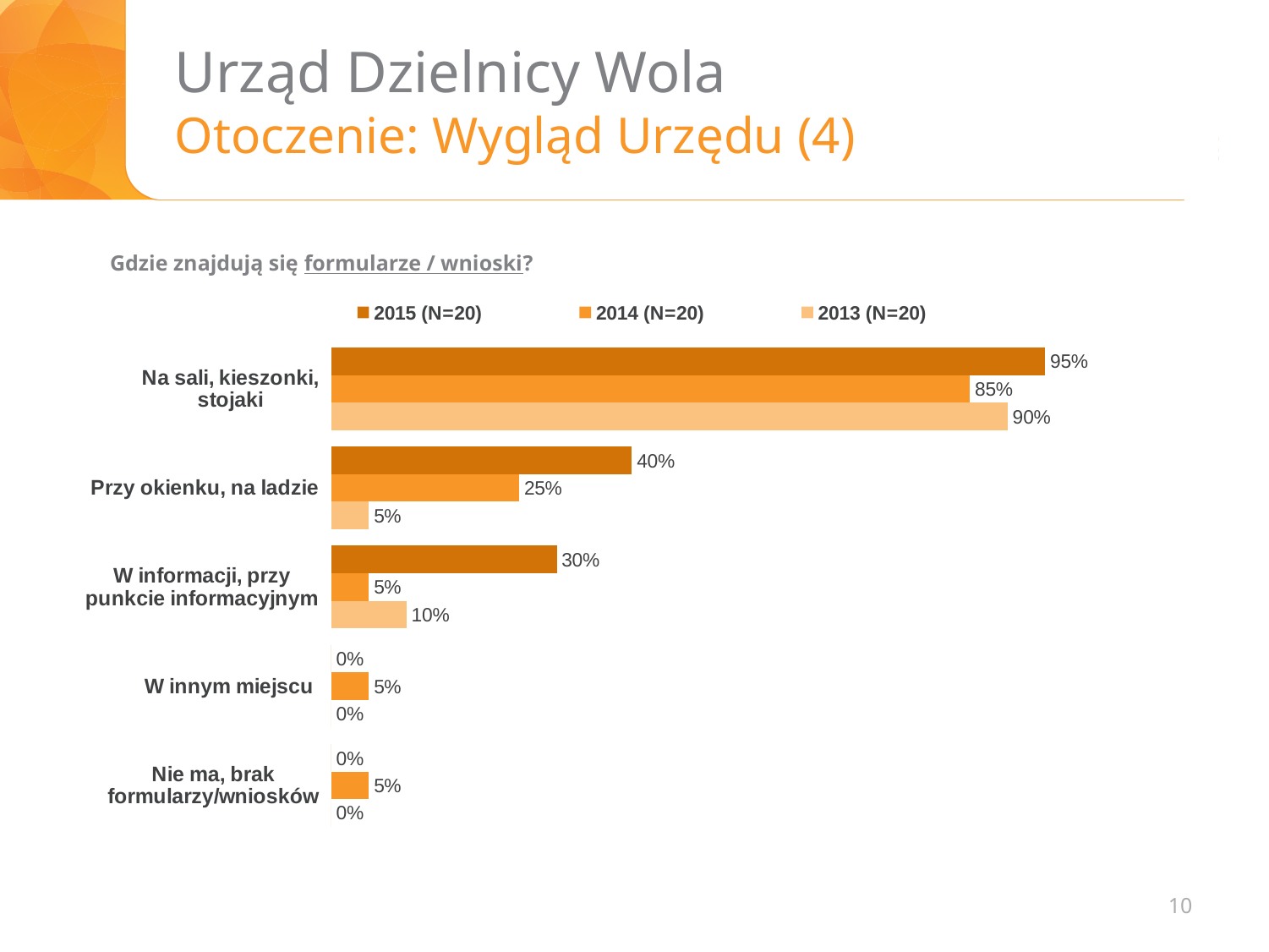
What is the difference between the 2015 (N=20) and 2014 (N=20) values for "Przy okienku, na ladzie"? 15 percentage points For "Na sali, kieszonki, stojaki", which is larger: the 2014 (N=20) value or the 2013 (N=20) value? 2013 (N=20) What is the value for "Przy okienku, na ladzie" in the 2013 (N=20) series? 5% What kind of chart is shown on the slide? Bar chart Which category has the lowest value in the 2014 (N=20) series? W informacji, przy punkcie informacyjnym, W innym miejscu, and Nie ma, brak formularzy/wniosków (all 5%) What question does the chart answer, as written above it? Gdzie znajdują się formularze / wnioski? What is the value for "W informacji, przy punkcie informacyjnym" in the 2014 (N=20) series? 5% Which category has the highest value in the 2015 (N=20) series? Na sali, kieszonki, stojaki What is the value for "Na sali, kieszonki, stojaki" in the 2015 (N=20) series? 95% How many categories are shown on the chart? 5 How many series does the legend list? 3 What is the difference between the 2015 (N=20) and 2013 (N=20) values for "W informacji, przy punkcie informacyjnym"? 20 percentage points